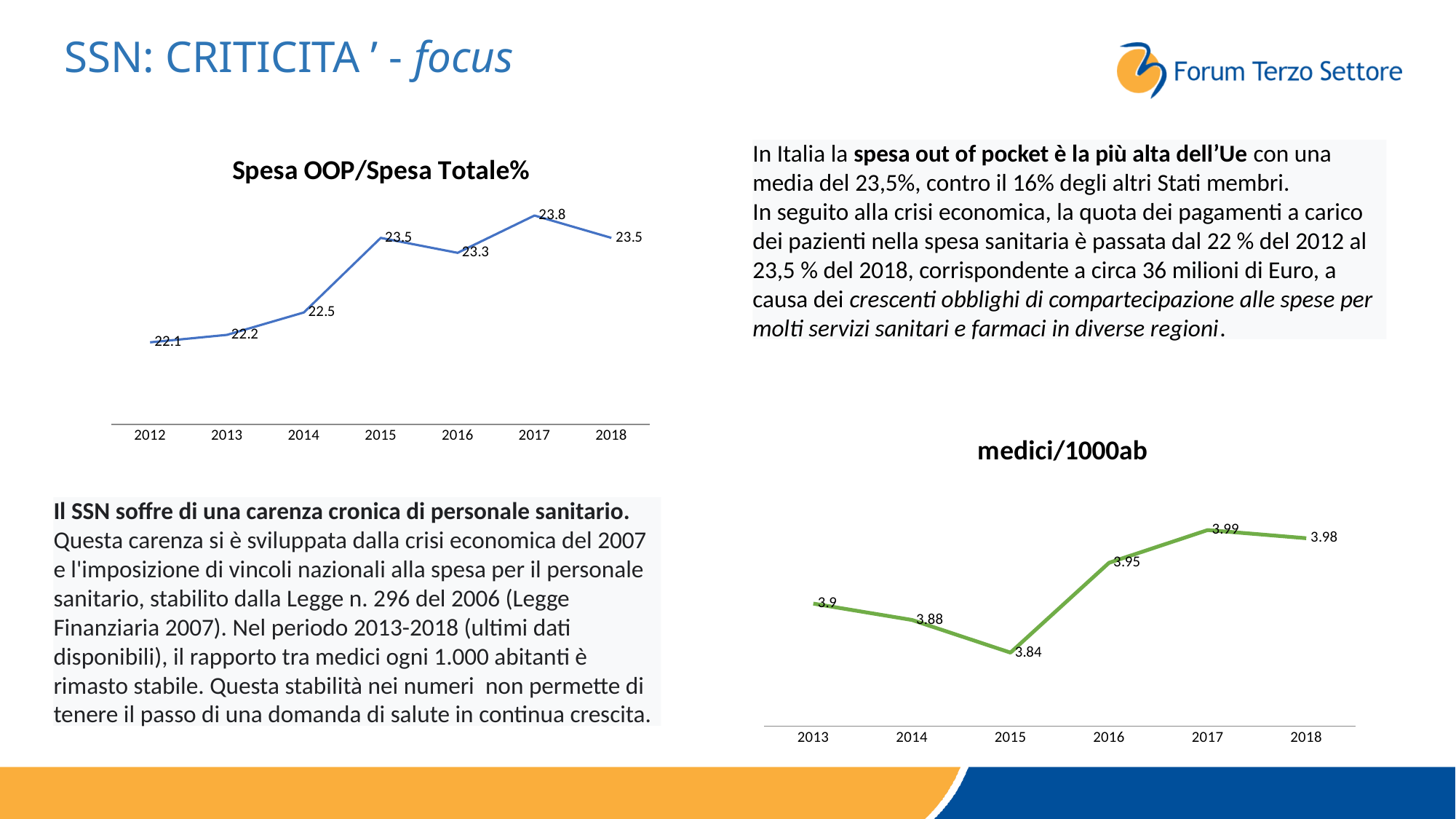
In the 'medici/1000ab' chart, which year has the highest value? 2017 In the 'medici/1000ab' chart, is the value for 2016 larger or smaller than the value for 2014? larger In the 'Spesa OOP/Spesa Totale%' chart, does the value rise or fall from 2012 to 2015? rise In the 'medici/1000ab' chart, what is the difference between the 2017 value and the 2015 value? 0.15 In the 'Spesa OOP/Spesa Totale%' chart, how many years are plotted? 7 In the 'medici/1000ab' chart, which year has the lowest value? 2015 In the 'Spesa OOP/Spesa Totale%' chart, which year has the highest value? 2017 In the 'medici/1000ab' chart, what is the value for 2015? 3.84 In the 'Spesa OOP/Spesa Totale%' chart, what is the difference between the 2017 value and the 2012 value? 1.7 In the 'Spesa OOP/Spesa Totale%' chart, which year has the lowest value? 2012 In the 'Spesa OOP/Spesa Totale%' chart, what is the value for 2015? 23.5 What type of chart is the 'medici/1000ab' chart? line chart